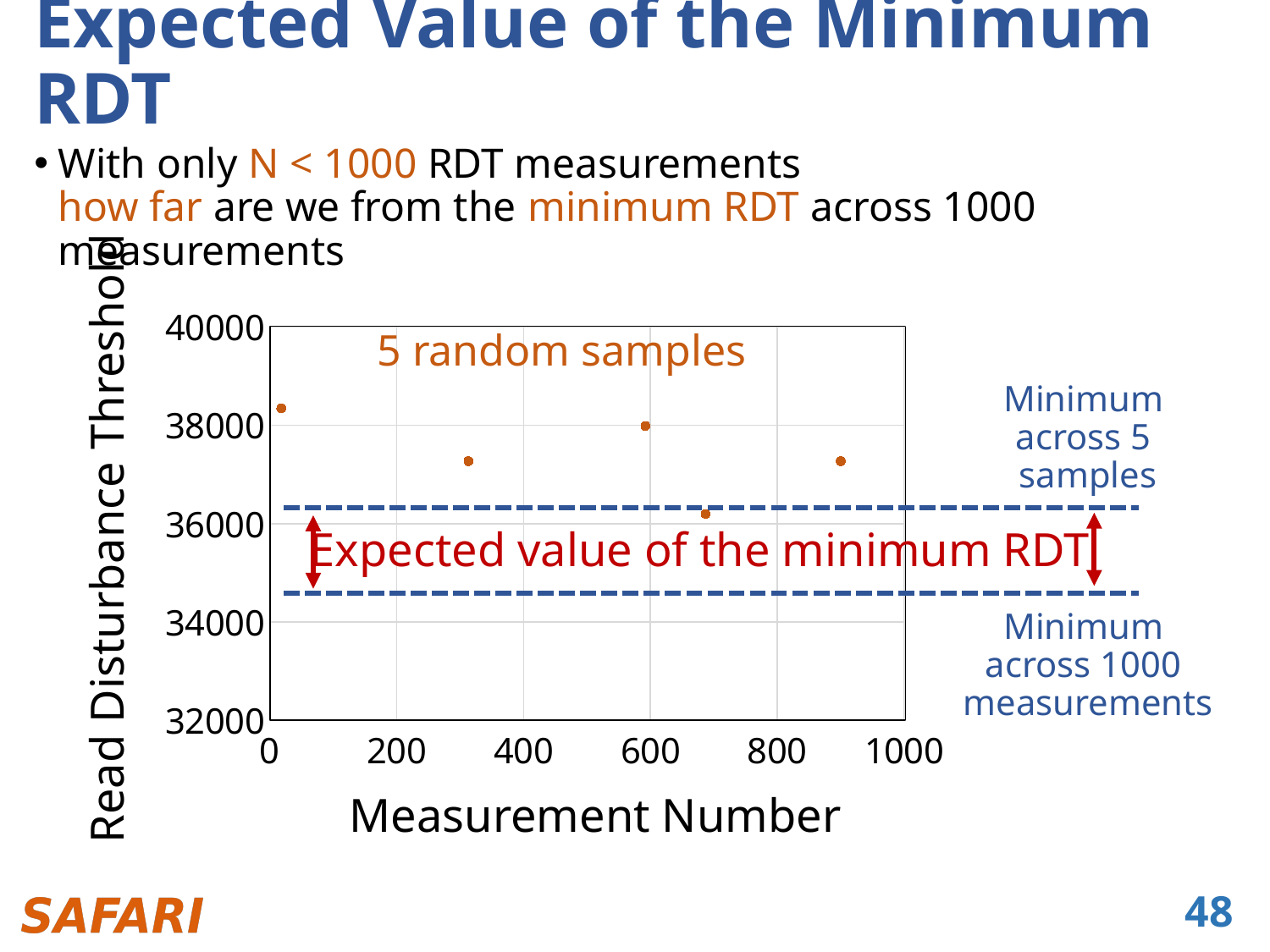
How many data points are plotted in the chart? 5 Is the Read Disturbance Threshold of the data point near Measurement Number 300 greater or less than 36000? greater Is the Read Disturbance Threshold of the data point near Measurement Number 700 greater or less than 37000? less What is the label of the y-axis of the chart? Read Disturbance Threshold What is the label of the x-axis of the chart? Measurement Number Is the Read Disturbance Threshold of the data point near Measurement Number 900 greater or less than 38000? less Which has a larger Read Disturbance Threshold: the data point near Measurement Number 0 or the one near Measurement Number 700? the one near Measurement Number 0 What kind of chart is shown on the slide? scatter plot Which data point has the lowest Read Disturbance Threshold: the one near Measurement Number 700 or the one near Measurement Number 0? the one near Measurement Number 700 Which data point has the highest Read Disturbance Threshold, by approximate Measurement Number? the one near Measurement Number 0